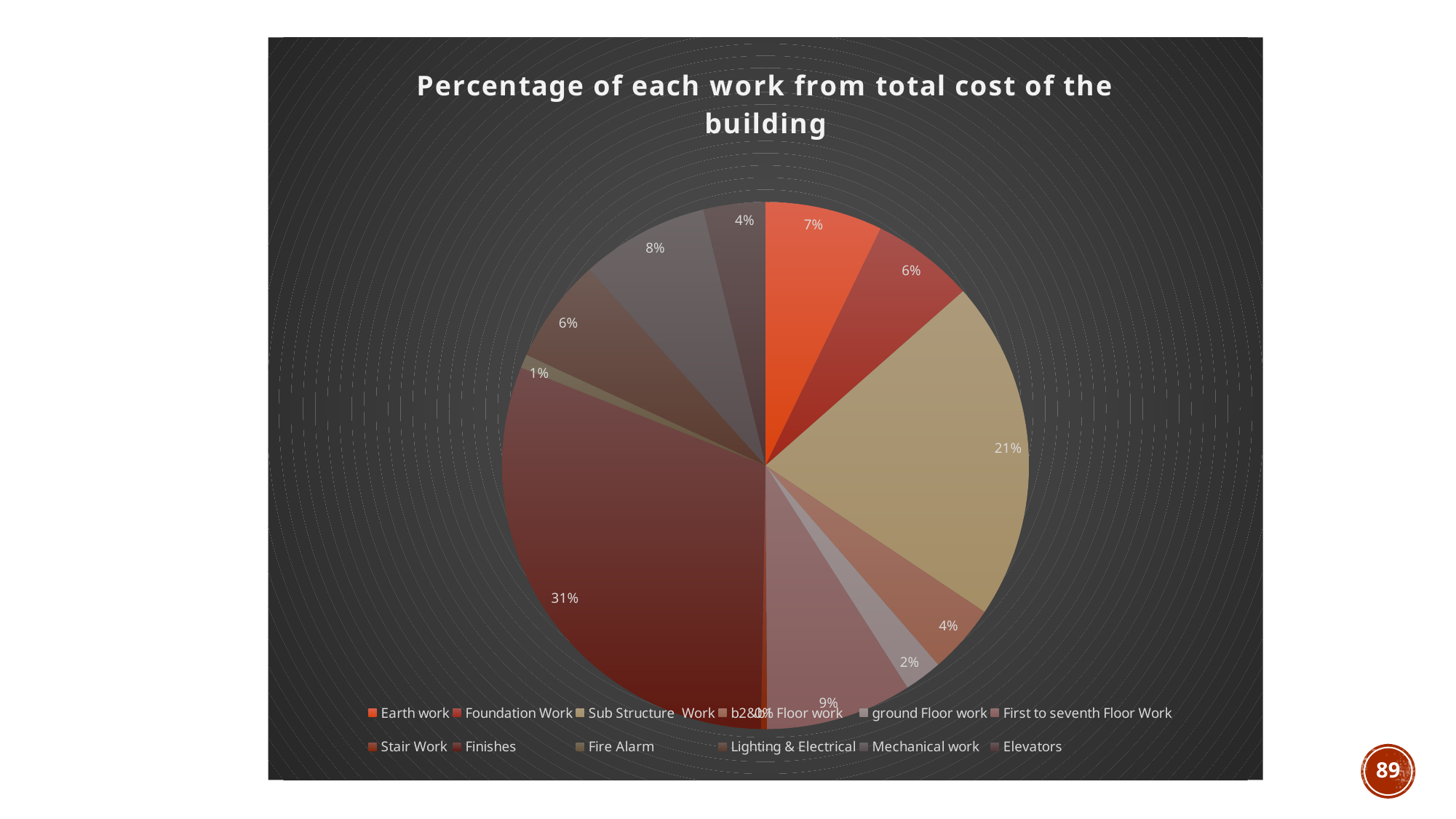
What percentage of the total cost is Earth work? 7% How many work categories does the legend list? 12 What percentage of the total cost is Fire Alarm? 1% Which work accounts for the largest share of the total cost? Finishes What is the title of the chart? Percentage of each work from total cost of the building What percentage of the total cost is Sub Structure Work? 21% What kind of chart is shown on the slide? pie chart How many percentage points larger is the Finishes share than the Sub Structure Work share? 10 What percentage of the total cost is Finishes? 31% Which has a larger share of the total cost, Earth work or Foundation Work? Earth work What percentage of the total cost is First to seventh Floor Work? 9% What percentage of the total cost is Mechanical work? 8%